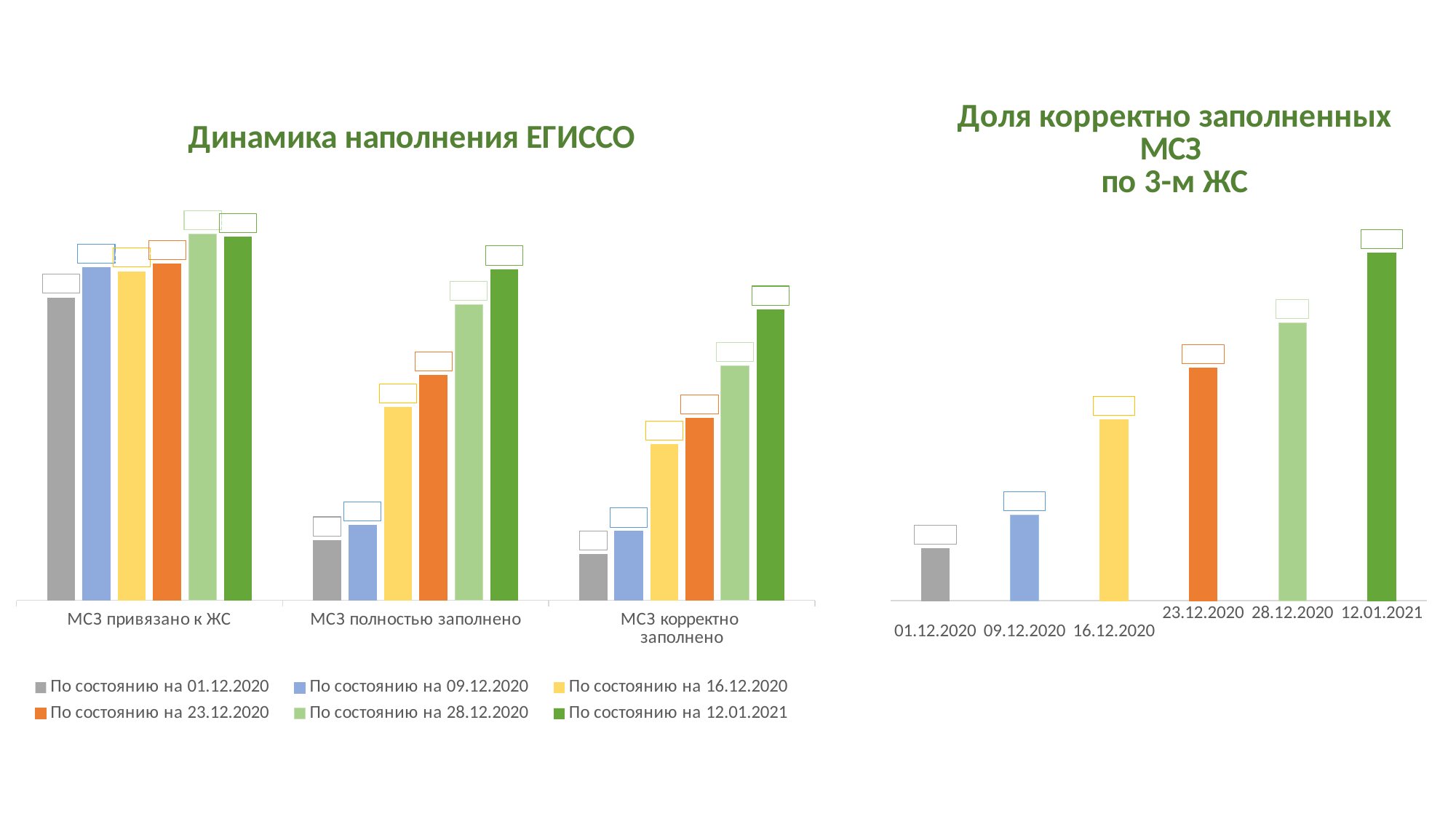
In the left chart "Динамика наполнения ЕГИССО", how many series does the legend list? 6 In the left chart "Динамика наполнения ЕГИССО", which colour represents the series "По состоянию на 23.12.2020"? orange In the left chart "Динамика наполнения ЕГИССО", which series has the highest bar for "МСЗ полностью заполнено"? По состоянию на 12.01.2021 In the right chart "Доля корректно заполненных МСЗ по 3-м ЖС", which date has the lowest bar? 01.12.2020 In the right chart "Доля корректно заполненных МСЗ по 3-м ЖС", which date has the highest bar? 12.01.2021 What kind of chart is the right chart titled "Доля корректно заполненных МСЗ по 3-м ЖС"? bar chart In the left chart "Динамика наполнения ЕГИССО", for "МСЗ корректно заполнено", which is larger: the bar for 23.12.2020 or the bar for 16.12.2020? 23.12.2020 In the left chart "Динамика наполнения ЕГИССО", which series has the lowest bar for "МСЗ корректно заполнено"? По состоянию на 01.12.2020 What kind of chart is the left chart titled "Динамика наполнения ЕГИССО"? bar chart In the right chart "Доля корректно заполненных МСЗ по 3-м ЖС", how many dates are shown on the x axis? 6 In the left chart "Динамика наполнения ЕГИССО", how many categories are shown on the x axis? 3 In the right chart "Доля корректно заполненных МСЗ по 3-м ЖС", do the values rise or fall from 01.12.2020 to 12.01.2021? rise